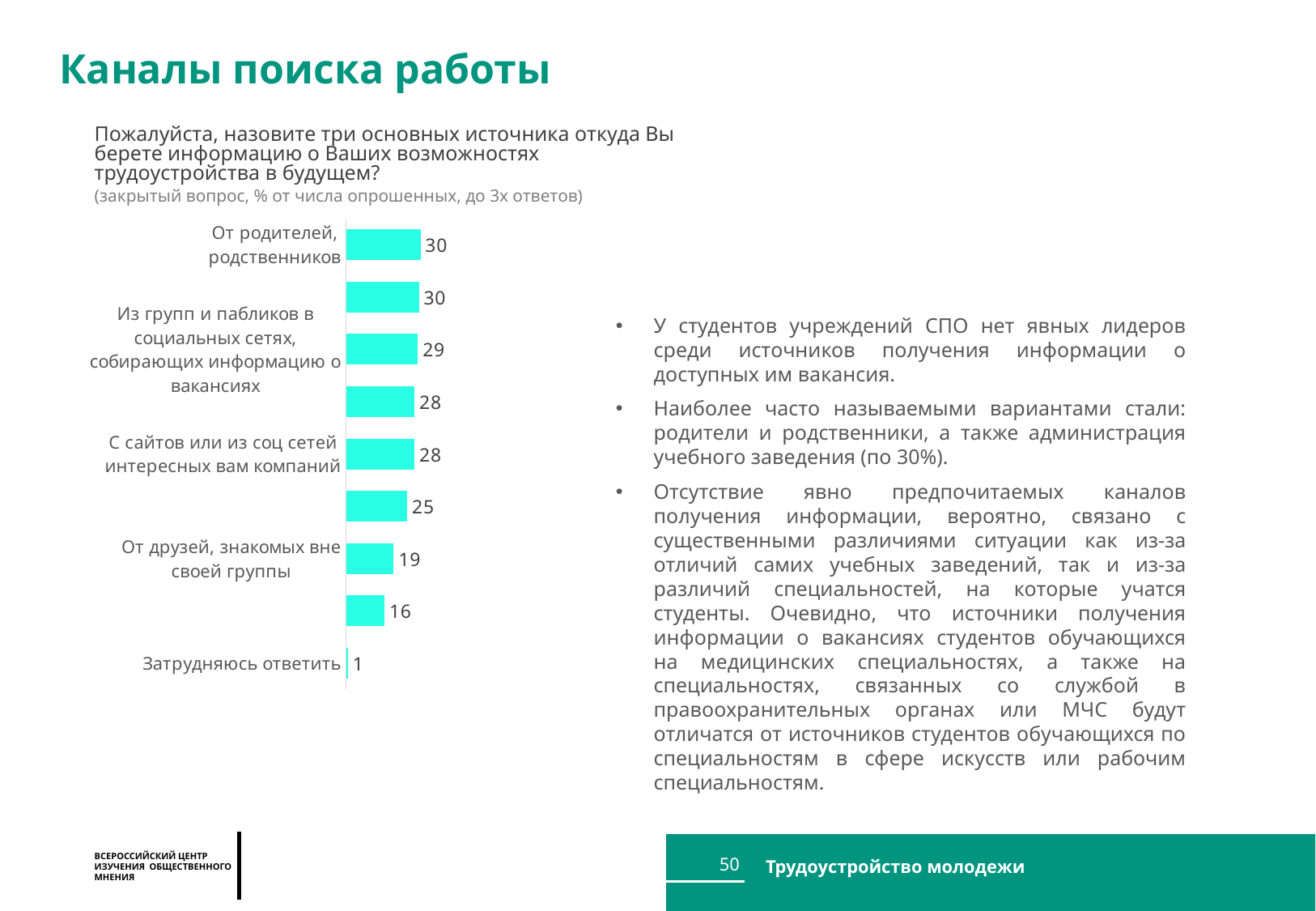
Which category has the lowest value in the chart? Затрудняюсь ответить What value is shown for "От родителей, родственников"? 30 What is the highest value shown in the chart? 30 What kind of chart is shown on the slide? Bar chart Which is larger: the value for "От родителей, родственников" or the value for "От друзей, знакомых вне своей группы"? От родителей, родственников What is the difference between the values for "С сайтов или из соц сетей интересных вам компаний" and "От друзей, знакомых вне своей группы"? 9 How many bars are plotted in the chart? 9 What is the difference between the values for "От родителей, родственников" and "Затрудняюсь ответить"? 29 What value is shown for "С сайтов или из соц сетей интересных вам компаний"? 28 What value is shown for "Затрудняюсь ответить"? 1 Do the bar values increase or decrease from the top of the chart to the bottom? Decrease What value is shown for "От друзей, знакомых вне своей группы"? 19